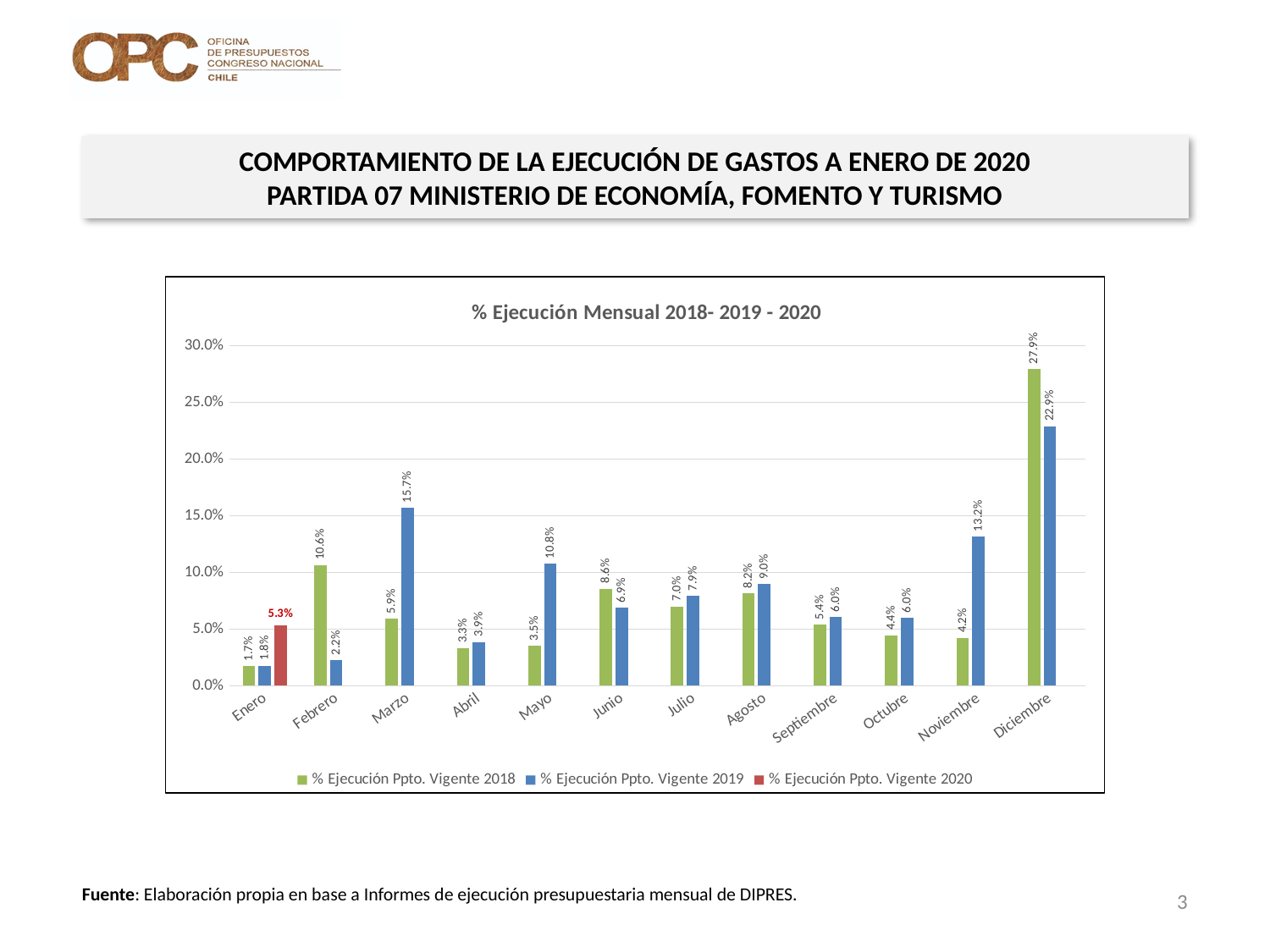
What is the value of % Ejecución Ppto. Vigente 2019 for Marzo? 15.7% What is the value of % Ejecución Ppto. Vigente 2020 for Enero? 5.3% Which month has the highest value for % Ejecución Ppto. Vigente 2019? Diciembre What kind of chart is shown on the slide? Bar chart How many months are shown on the x axis? 12 Which month has the lowest value for % Ejecución Ppto. Vigente 2018? Enero What is the difference between the 2018 and 2019 values for Diciembre? 5.0% What is the title of the chart? % Ejecución Mensual 2018- 2019 - 2020 How many series does the legend list? 3 What is the value of % Ejecución Ppto. Vigente 2018 for Febrero? 10.6% Which is larger for Noviembre: the 2018 value or the 2019 value? 2019 Is the value for % Ejecución Ppto. Vigente 2019 in Mayo greater or less than 10.0%? greater